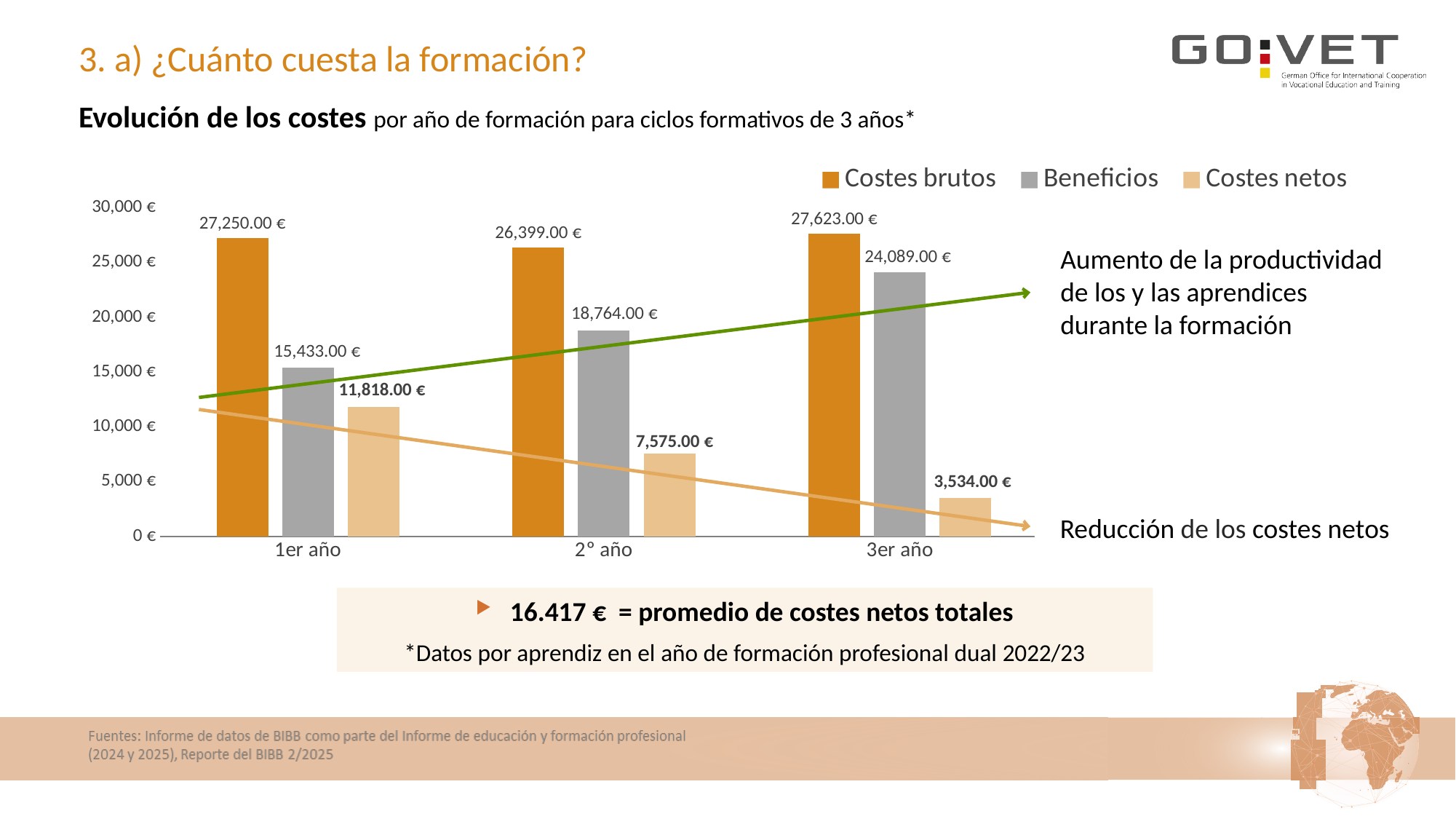
What is the value of Costes netos for 3er año? 3,534.00 € Which is larger for 2° año: Costes brutos or Beneficios? Costes brutos What is the value of Costes brutos for 1er año? 27,250.00 € What is the value of Beneficios for 3er año? 24,089.00 € In which year is Costes brutos highest? 3er año What is the value of Beneficios for 2° año? 18,764.00 € What is the difference between Costes brutos and Beneficios for 1er año? 11,817.00 € How many series does the legend list? 3 Do the Costes netos values rise or fall from 1er año to 3er año? Fall What kind of chart is shown on the slide? Bar chart In which year is Costes netos lowest? 3er año How many categories are shown on the x axis? 3